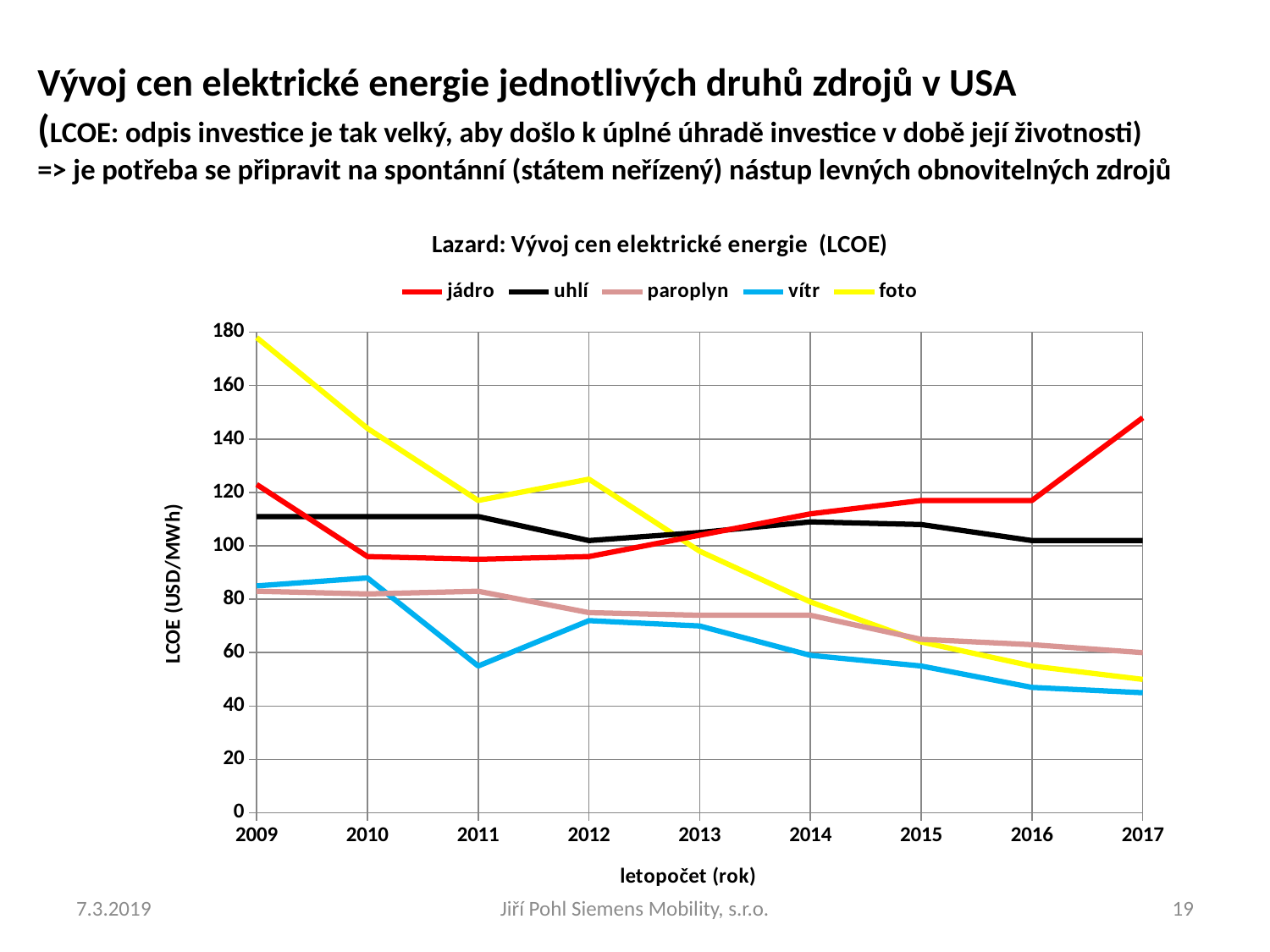
How many years are plotted along the x axis? 9 Which series has the lowest value in 2017? vítr Which series has the highest value in 2009? foto Which series has the highest value in 2017? jádro Does the foto series rise or fall from 2009 to 2017? fall What kind of chart is shown on the slide? line chart How many series does the chart legend list? 5 Is the value for foto in 2009 greater or less than 160? greater In 2017, which is larger, the value for uhlí or the value for paroplyn? uhlí Is the value for vítr in 2017 greater or less than 60? less Is the value for jádro in 2017 greater or less than 140? greater What is the label of the vertical axis? LCOE (USD/MWh)